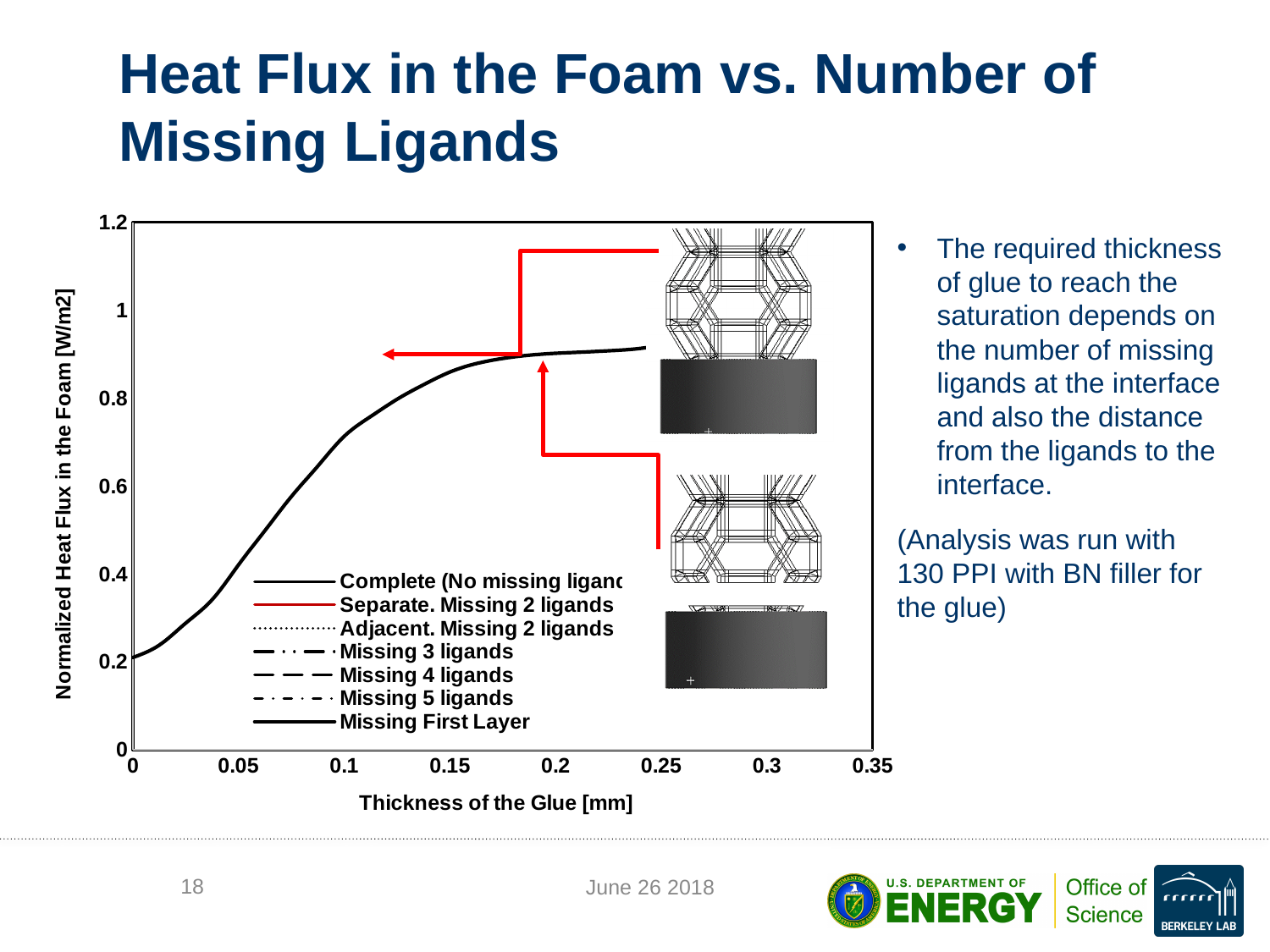
Is the normalized heat flux at a glue thickness of 0.05 mm greater or less than 0.6? less What colour is the legend line for "Separate. Missing 2 ligands"? red Does the plotted heat flux curve rise or fall as the thickness of the glue increases? rise Which has the larger normalized heat flux: a glue thickness of 0.05 mm or 0.2 mm? 0.2 mm Is the normalized heat flux at a glue thickness of 0.15 mm greater or less than 0.6? greater What kind of chart is shown on the slide? line chart Is the normalized heat flux at a glue thickness of 0.1 mm greater or less than 0.6? greater What is the label of the x axis of the chart? Thickness of the Glue [mm] How many series does the chart's legend list? 7